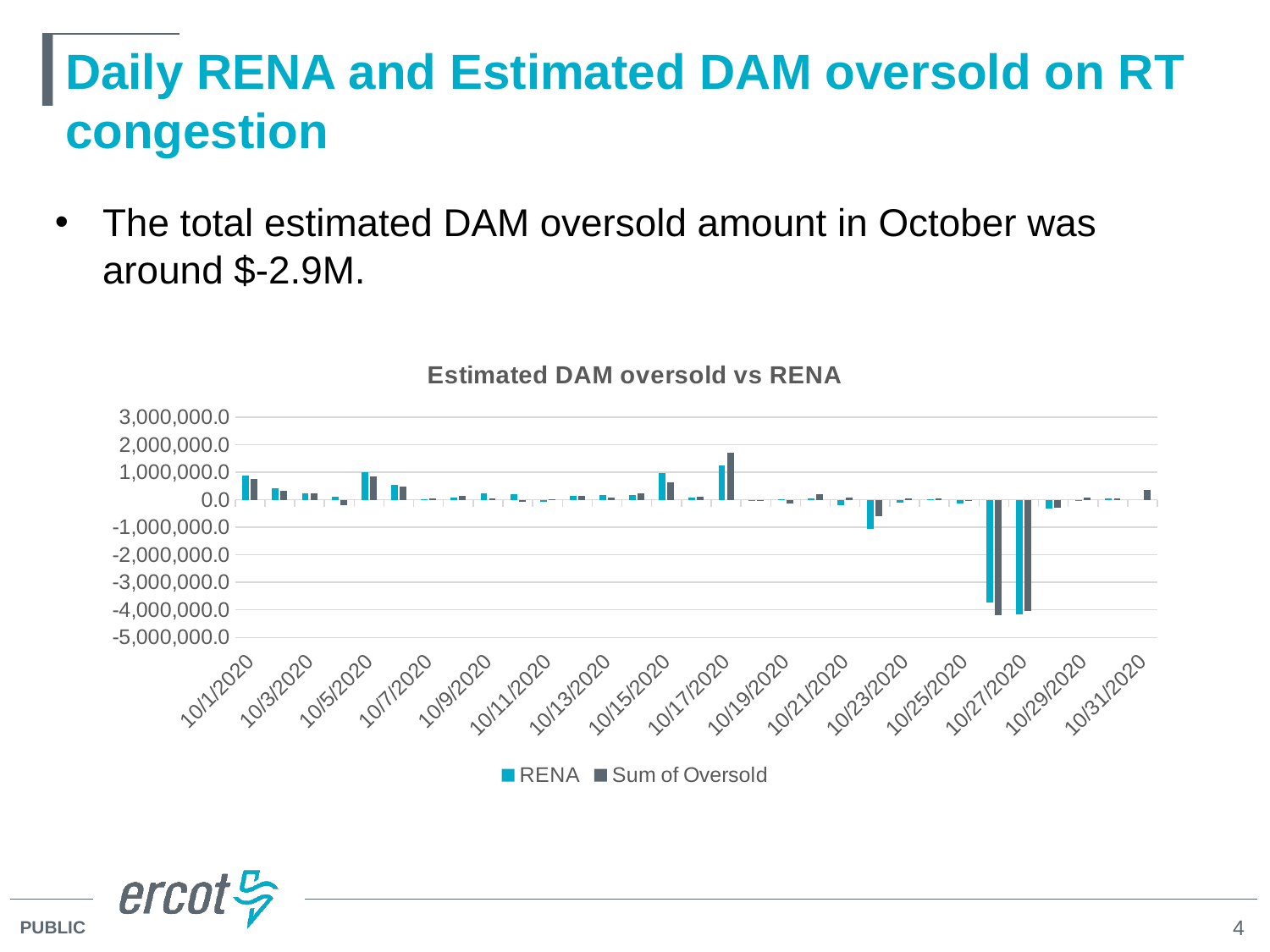
Is the lowest RENA value in the chart greater or less than -3,000,000.0? less Is the highest RENA value in the chart greater or less than 2,000,000.0? less What is the title of the chart? Estimated DAM oversold vs RENA On 10/17/2020, which series has the larger value, RENA or Sum of Oversold? Sum of Oversold Is the highest Sum of Oversold value in the chart greater or less than 1,000,000.0? greater What kind of chart is shown on the slide? bar chart What are the two series named in the chart legend? RENA and Sum of Oversold What is the lowest value shown on the chart's vertical axis? -5,000,000.0 How many series does the chart legend list? 2